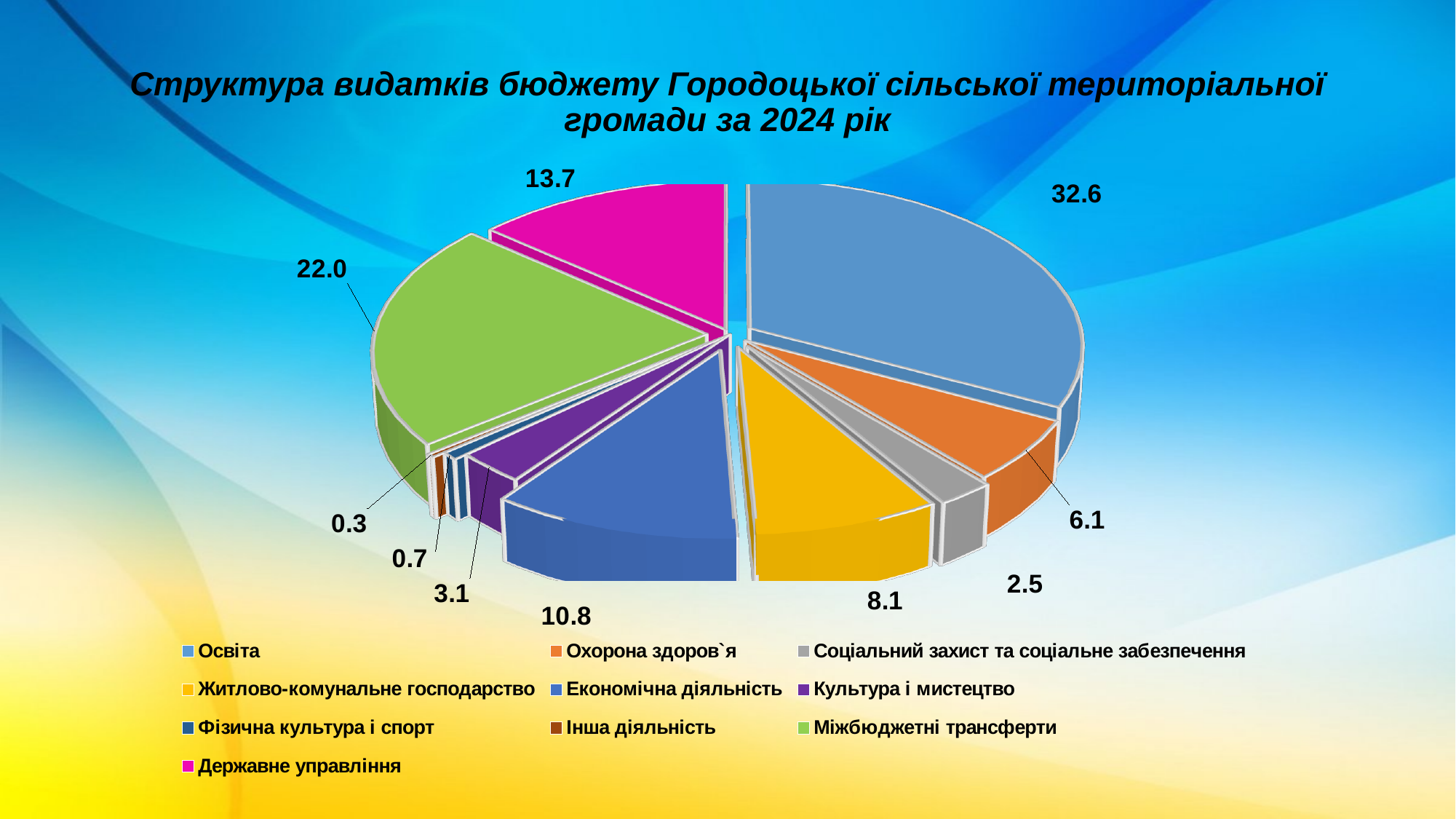
What is the title of the chart? Структура видатків бюджету Городоцької сільської територіальної громади за 2024 рік What is the value shown for Міжбюджетні трансферти? 22.0 What is the value shown for Державне управління? 13.7 Which is larger, the value for Охорона здоров`я or the value for Житлово-комунальне господарство? Житлово-комунальне господарство What is the value shown for Освіта? 32.6 What is the value shown for Соціальний захист та соціальне забезпечення? 2.5 What kind of chart is shown on the slide? pie chart What is the difference between the values for Освіта and Міжбюджетні трансферти? 10.6 What is the value shown for Економічна діяльність? 10.8 How many categories does the pie chart have? 10 Which category has the smallest slice of the pie? Інша діяльність Which category has the largest slice of the pie? Освіта